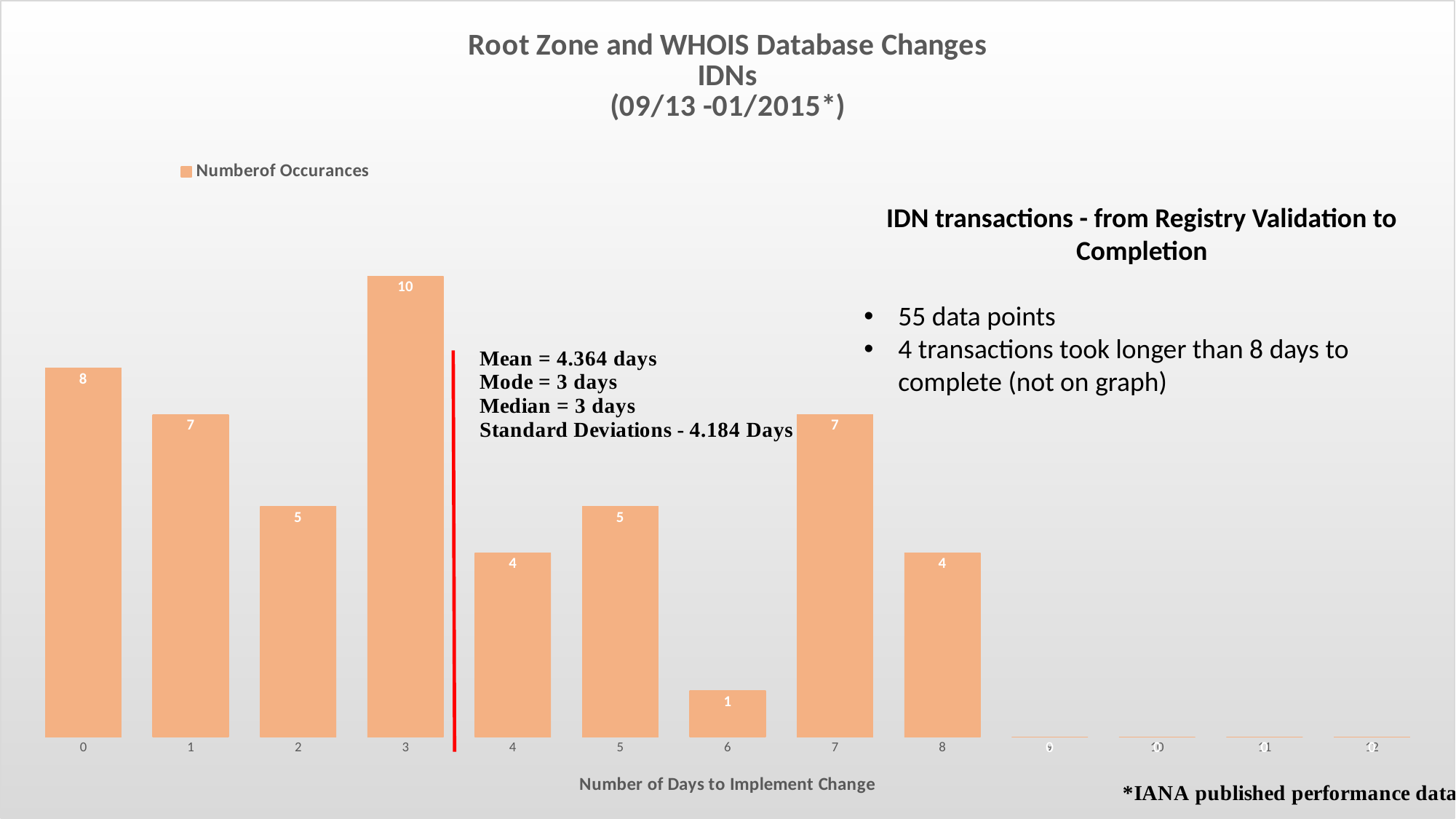
Which number of days has the highest number of occurrences? 3 How many series does the legend list? 1 What kind of chart is shown on the slide? Bar chart What is the difference in occurrences between 3 days and 4 days? 6 What is the number of occurrences for 8 days to implement change? 4 What is the number of occurrences for 0 days to implement change? 8 What is the number of occurrences for 6 days to implement change? 1 What is the total number of occurrences for 7 days and 8 days combined? 11 What is the number of occurrences for 3 days to implement change? 10 Which has more occurrences, 1 day or 2 days? 1 day What is the title of the x axis? Number of Days to Implement Change Among the days with a labelled bar, which number of days has the lowest number of occurrences? 6